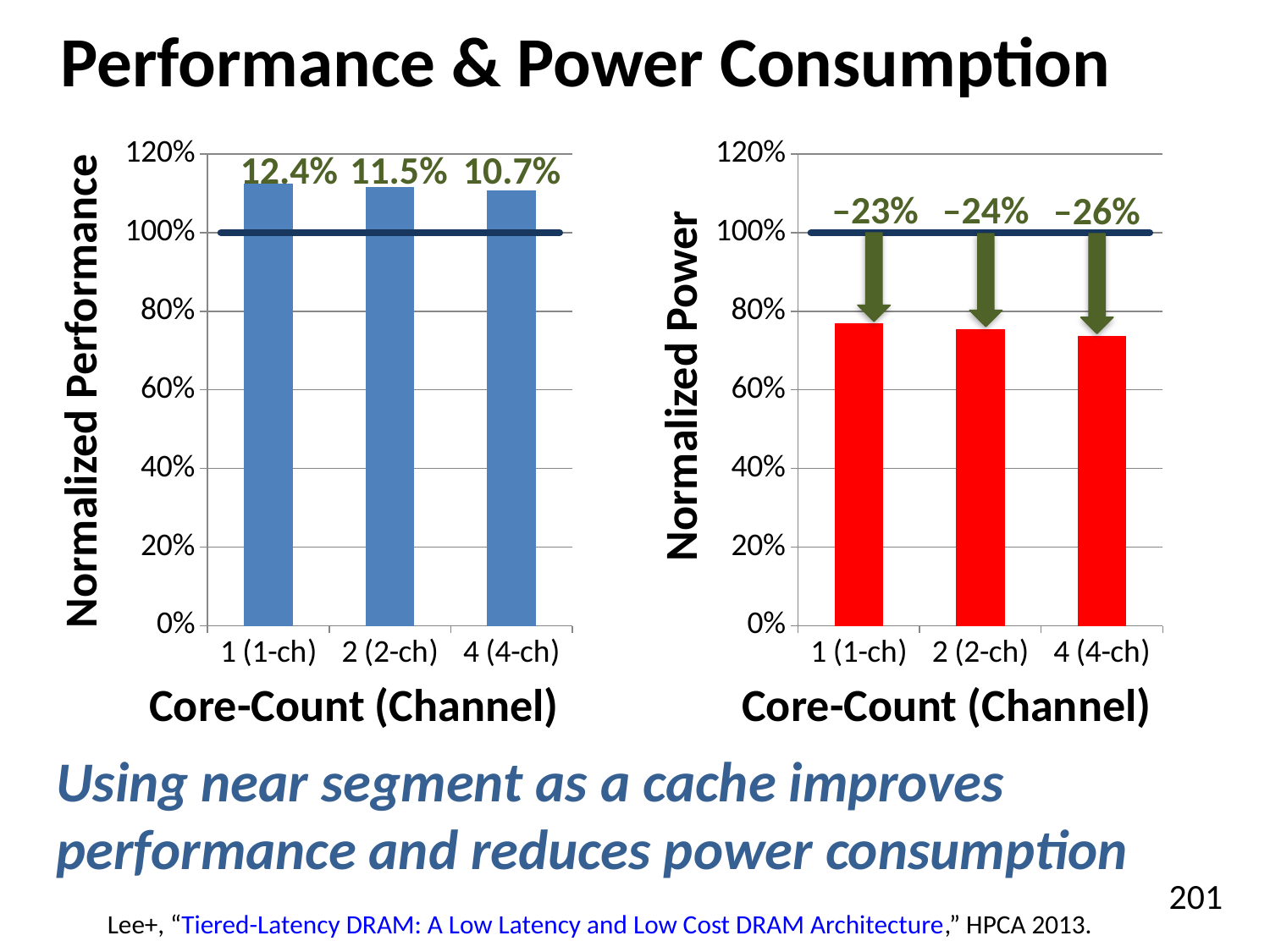
What kind of chart is the Normalized Performance chart? Bar chart What is the x-axis title of the Normalized Performance chart? Core-Count (Channel) In the Normalized Performance chart, which core-count configuration has the highest bar? 1 (1-ch) In the Normalized Performance chart, is the value for 2 (2-ch) greater or less than 100%? greater In the Normalized Power chart, what percentage label is shown above the bar for 4 (4-ch)? –26% In the Normalized Performance chart, what percentage label is shown above the bar for 1 (1-ch)? 12.4% In the Normalized Power chart, do the bar values rise or fall as the core count increases from 1 to 4? Fall How many core-count configurations are plotted in the Normalized Power chart? 3 In the Normalized Power chart, which core-count configuration has the lowest bar? 4 (4-ch) In the Normalized Performance chart, what percentage label is shown above the bar for 4 (4-ch)? 10.7% In the Normalized Power chart, is the value for 1 (1-ch) greater or less than 80%? less In the Normalized Power chart, what percentage label is shown above the bar for 2 (2-ch)? –24%